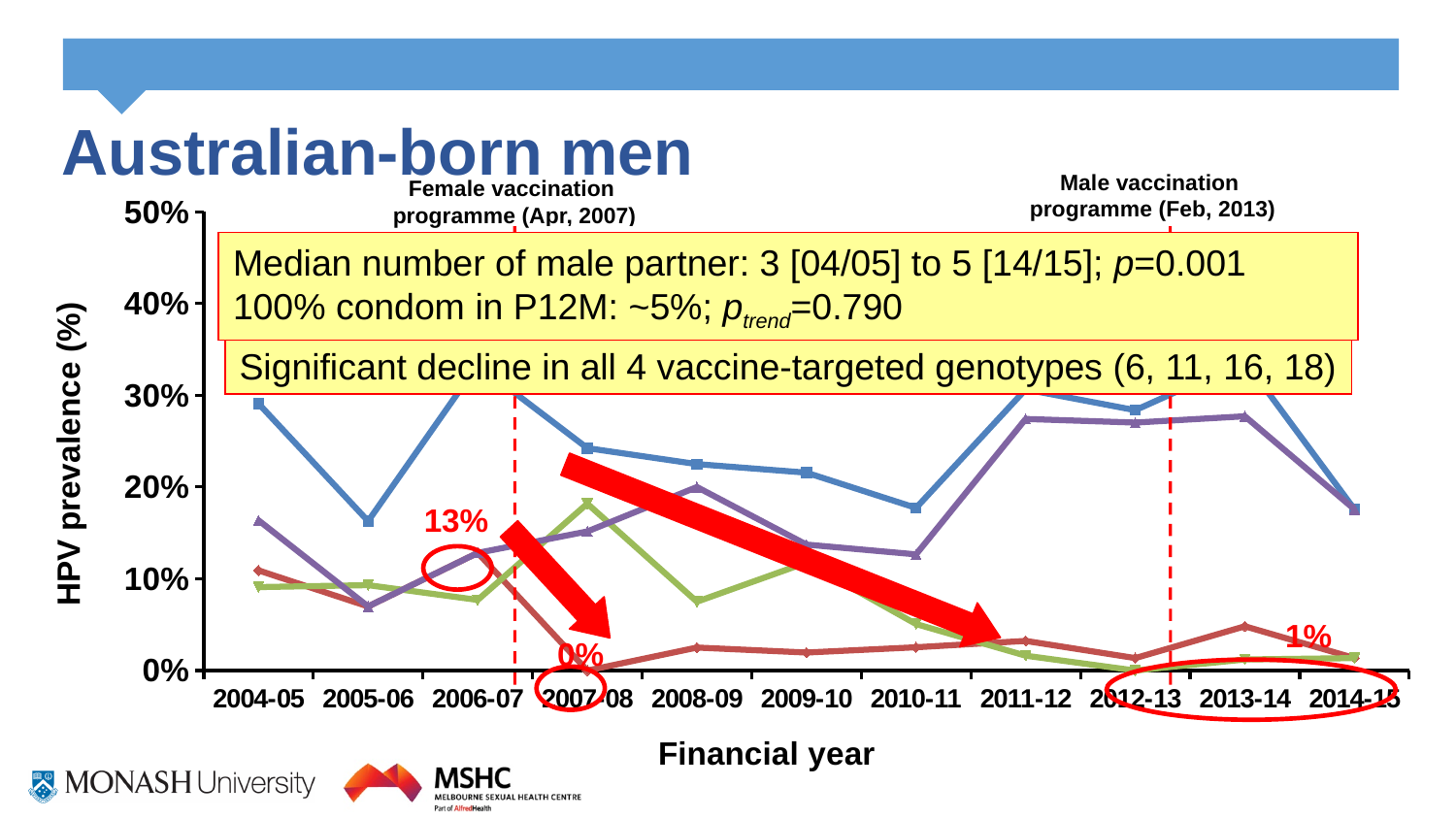
Is the value of the blue line at 2005-06 greater or less than 20%? less What is the label of the y axis of the chart? HPV prevalence (%) What value is labelled in red on the chart near 2013-14 and 2014-15? 1% At 2008-09, which line has the larger value, the blue line or the green line? blue line What value is labelled in red on the chart at 2006-07? 13% What is the title of the chart on the slide? Australian-born men What value is labelled in red on the chart at 2007-08? 0% Is the value of the blue line at 2004-05 greater or less than 20%? greater What is the difference between the labelled value at 2006-07 (13%) and the labelled value at 2007-08 (0%)? 13% How many financial years are shown on the x axis of the chart? 11 What kind of chart is shown on the slide? line chart Overall, does the green line rise or fall from 2007-08 to 2012-13? fall